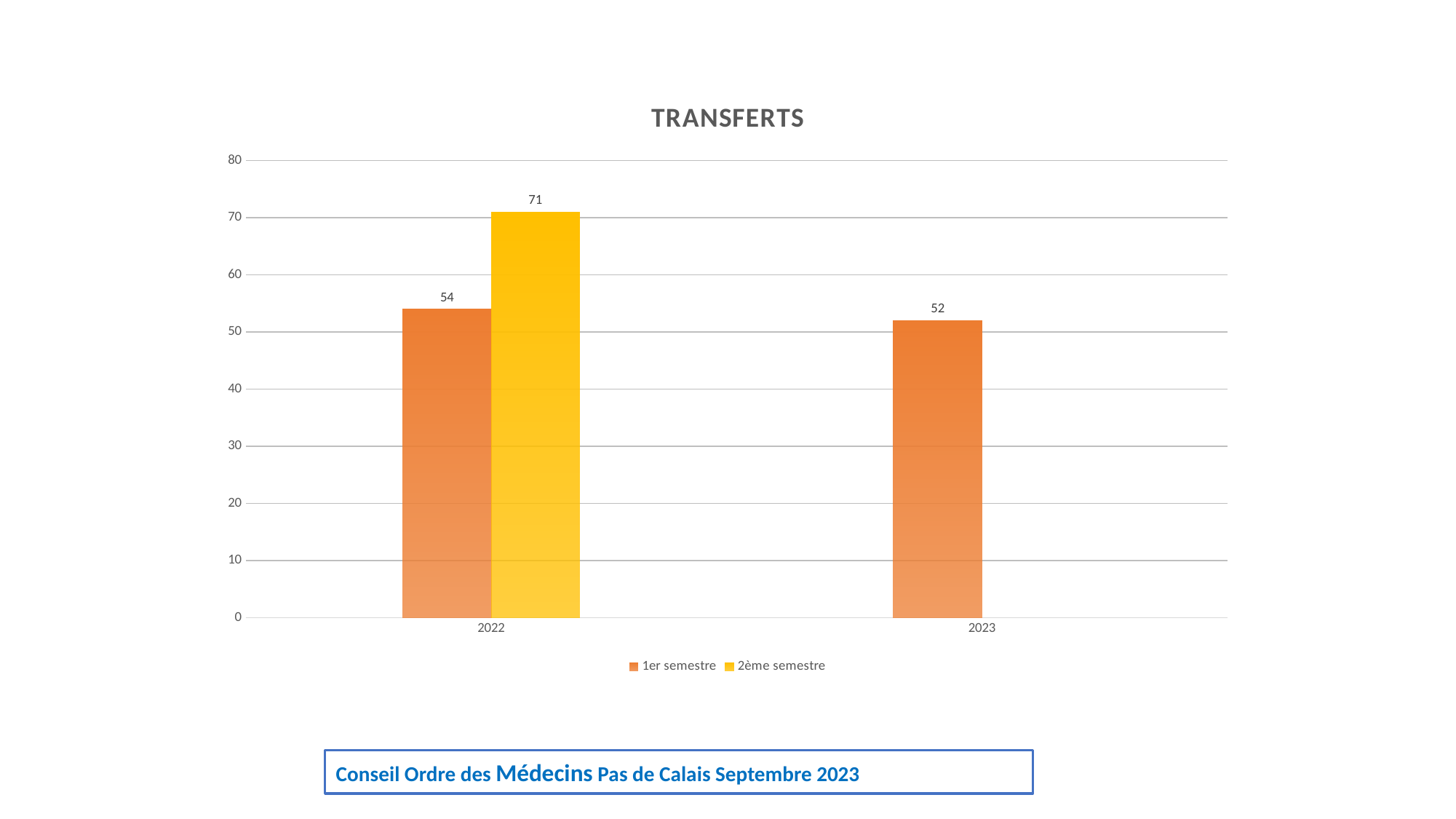
What is the value for 2ème semestre in 2022? 71 Which bar has the lowest value on the chart? 1er semestre 2023 What is the title of the chart? TRANSFERTS What is the difference between the 1er semestre values for 2022 and 2023? 2 Which is larger: 1er semestre in 2022 or 2ème semestre in 2022? 2ème semestre in 2022 How many series does the legend list? 2 What is the value for 1er semestre in 2023? 52 Is the value for 2ème semestre in 2022 greater or less than 60? greater What is the value for 1er semestre in 2022? 54 Which bar has the highest value on the chart? 2ème semestre 2022 What is the difference between the 2ème semestre and 1er semestre values in 2022? 17 What kind of chart is shown on the slide? Bar chart